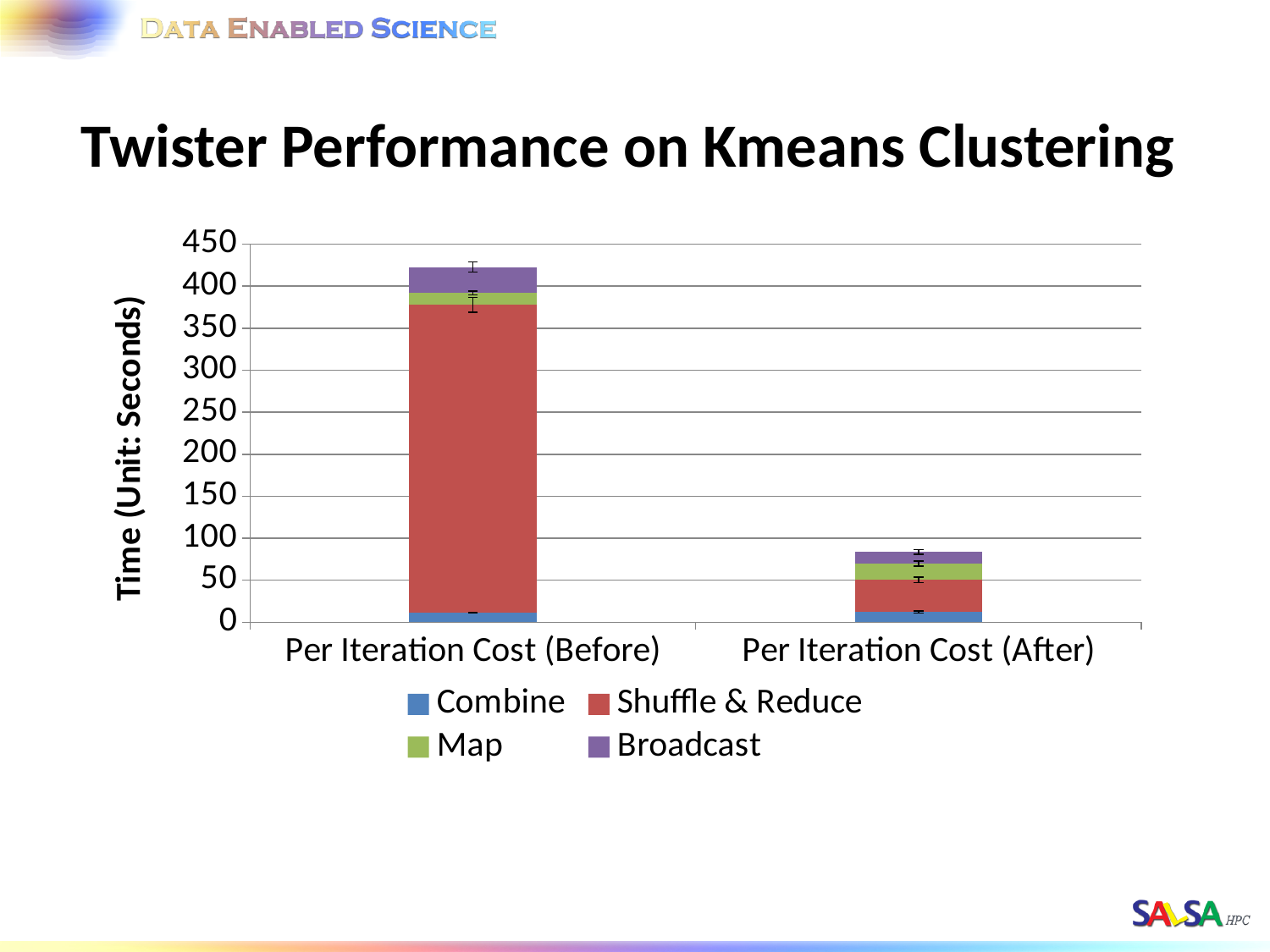
How many series does the legend list? 4 Is the total value for Per Iteration Cost (Before) greater or less than 400? greater Is the Combine segment for Per Iteration Cost (Before) greater or less than 50? less What kind of chart is shown on the slide? Stacked bar chart Is the Shuffle & Reduce segment for Per Iteration Cost (Before) greater or less than 300? greater How many categories are shown on the x axis? 2 Which category has the lowest total time? Per Iteration Cost (After) Which series is shown in red? Shuffle & Reduce What is the title of the y axis? Time (Unit: Seconds) Do the total values rise or fall from Per Iteration Cost (Before) to Per Iteration Cost (After)? fall Which category has the taller stacked bar, Per Iteration Cost (Before) or Per Iteration Cost (After)? Per Iteration Cost (Before)